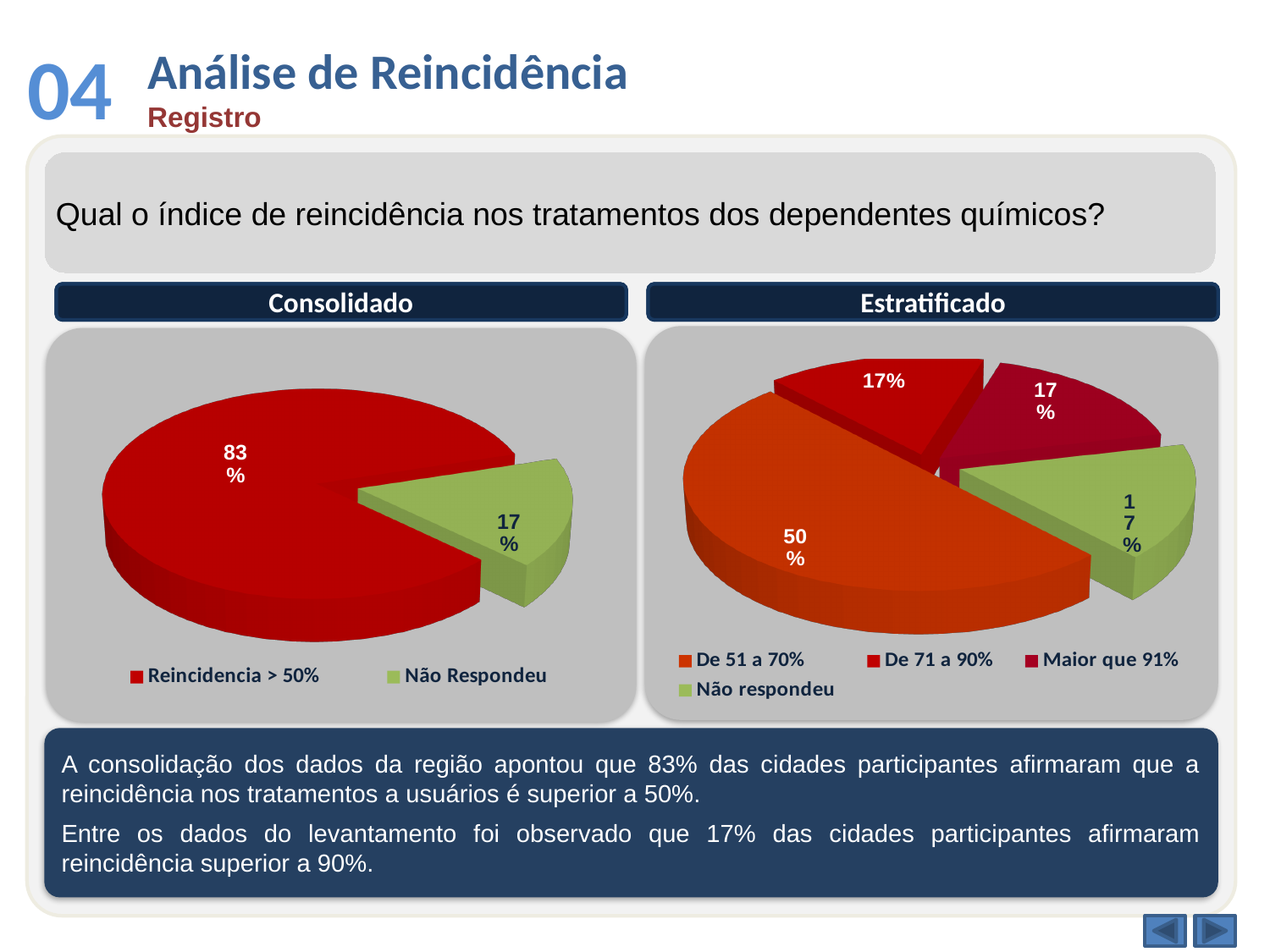
What type of chart is the Estratificado chart? Pie chart In the Consolidado chart, which category has the largest slice? Reincidencia > 50% In the Estratificado chart, which category has the largest slice? De 51 a 70% In the Estratificado chart, which is larger: De 51 a 70% or De 71 a 90%? De 51 a 70% In the Consolidado chart, what percentage is shown for Reincidencia > 50%? 83% In the Estratificado chart, what percentage is shown for De 51 a 70%? 50% In the Estratificado chart, what percentage is shown for Maior que 91%? 17% In the Consolidado chart, what percentage is shown for Não Respondeu? 17% In the Consolidado chart, what is the difference between the Reincidencia > 50% slice and the Não Respondeu slice? 66% In the Estratificado chart, what percentage is shown for Não respondeu? 17% How many categories does the legend of the Estratificado chart list? 4 How many slices does the Consolidado chart have? 2